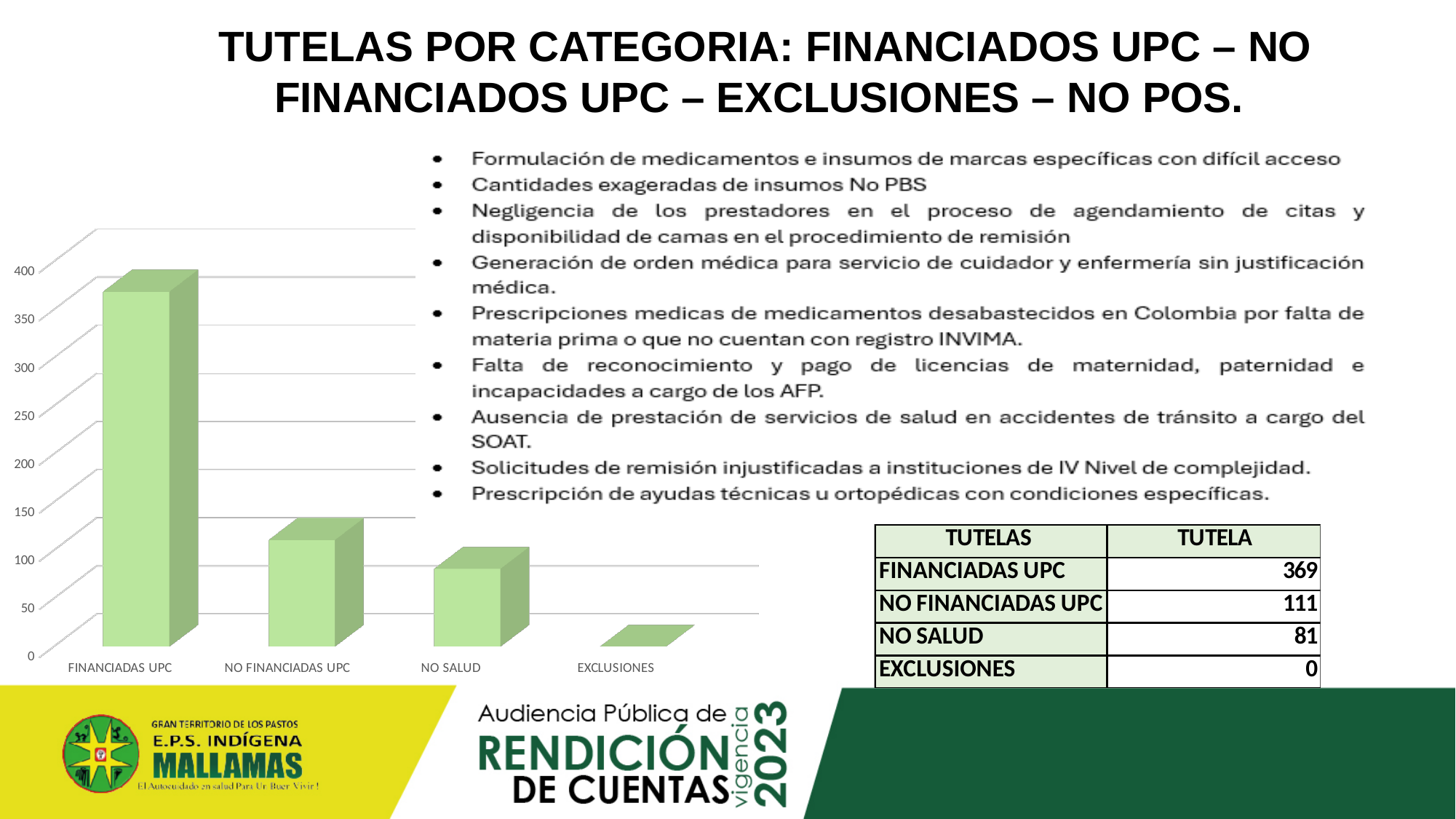
Which category has the lowest bar in the chart? EXCLUSIONES According to the table on the slide, how many tutelas are there for FINANCIADAS UPC? 369 Which is larger, the bar for NO FINANCIADAS UPC or the bar for NO SALUD? NO FINANCIADAS UPC How many categories are shown on the x axis of the chart? 4 According to the table on the slide, how many tutelas are there for EXCLUSIONES? 0 According to the table on the slide, how many tutelas are there for NO FINANCIADAS UPC? 111 Is the bar for NO SALUD greater or less than 100? less Is the bar for FINANCIADAS UPC greater or less than 350? greater What kind of chart is shown on the slide? bar chart Which category has the highest bar in the chart? FINANCIADAS UPC According to the table on the slide, how many tutelas are there for NO SALUD? 81 Using the values in the table, what is the difference between FINANCIADAS UPC and NO FINANCIADAS UPC? 258